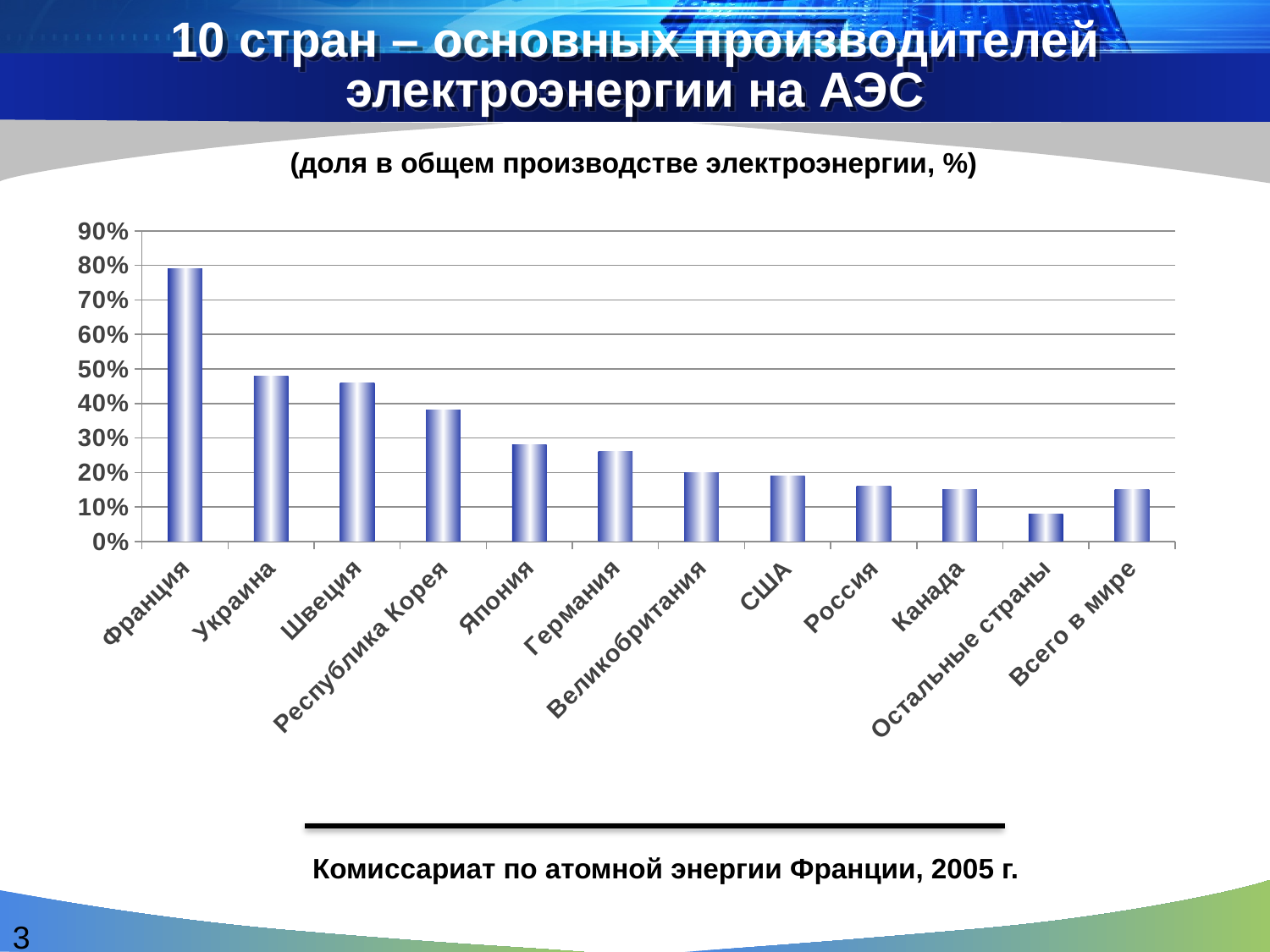
Which is larger, the value for Франция or the value for Украина? Франция Is the value for Япония greater or less than 30%? less Is the value for Франция greater or less than 70%? greater Which category has the highest value? Франция Which category has the lowest value? Остальные страны Is the value for Остальные страны greater or less than 10%? less Which is larger, the value for Россия or the value for Япония? Япония What kind of chart is shown on the slide? bar chart What is the subtitle shown above the chart? (доля в общем производстве электроэнергии, %) How many categories are plotted on the x axis? 12